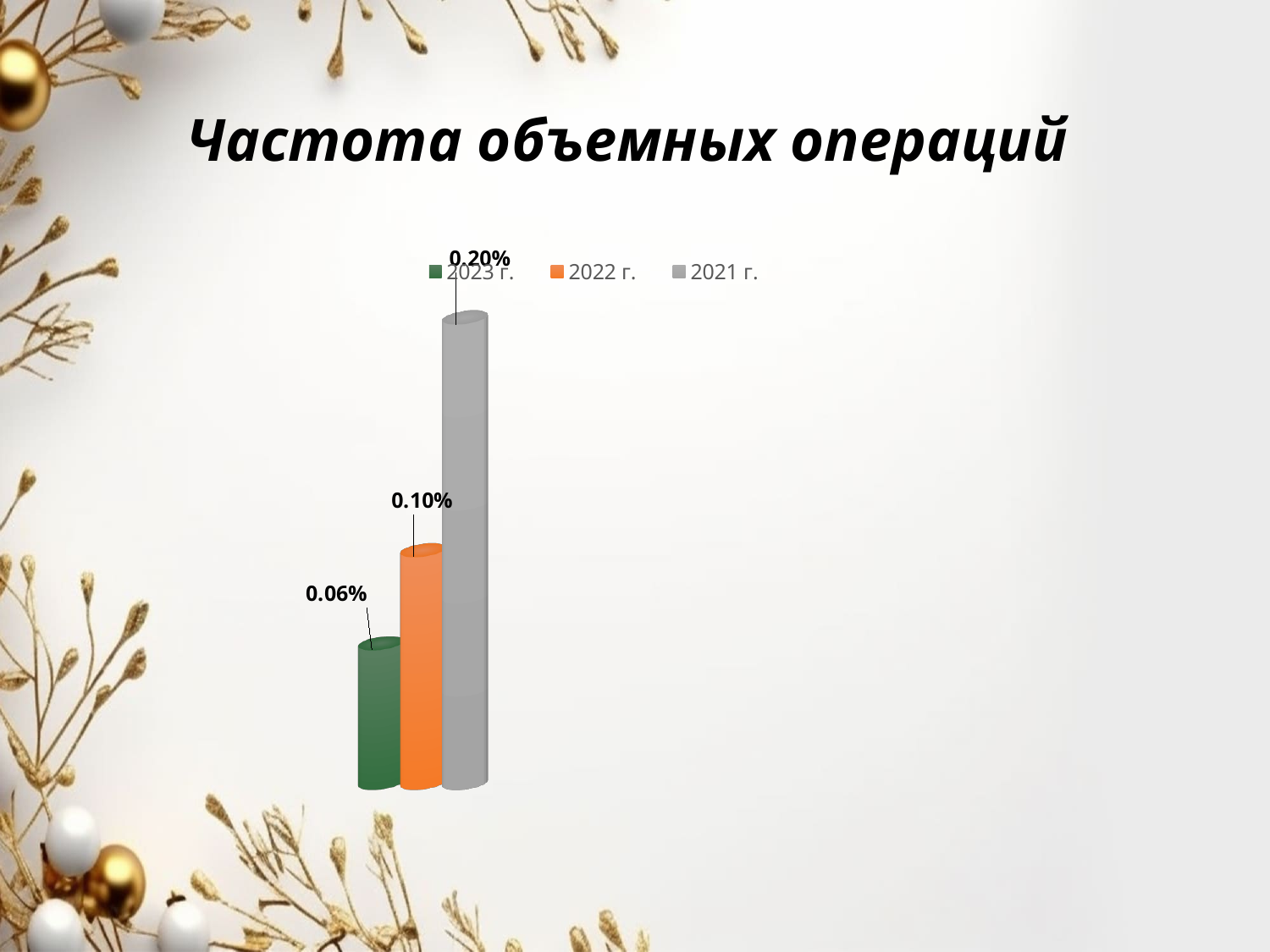
What colour is the bar for 2022 г.? Orange How many series does the legend list? 3 What is the difference between the values for 2021 г. and 2022 г.? 0.10% Which year has the lowest value? 2023 г. What is the value for 2023 г.? 0.06% What is the value for 2022 г.? 0.10% Which year has the highest value? 2021 г. What is the value for 2021 г.? 0.20% What kind of chart is shown on the slide? Bar chart Which is larger, the value for 2022 г. or the value for 2023 г.? 2022 г. What is the difference between the values for 2022 г. and 2023 г.? 0.04% What is the title of the chart? Частота объемных операций